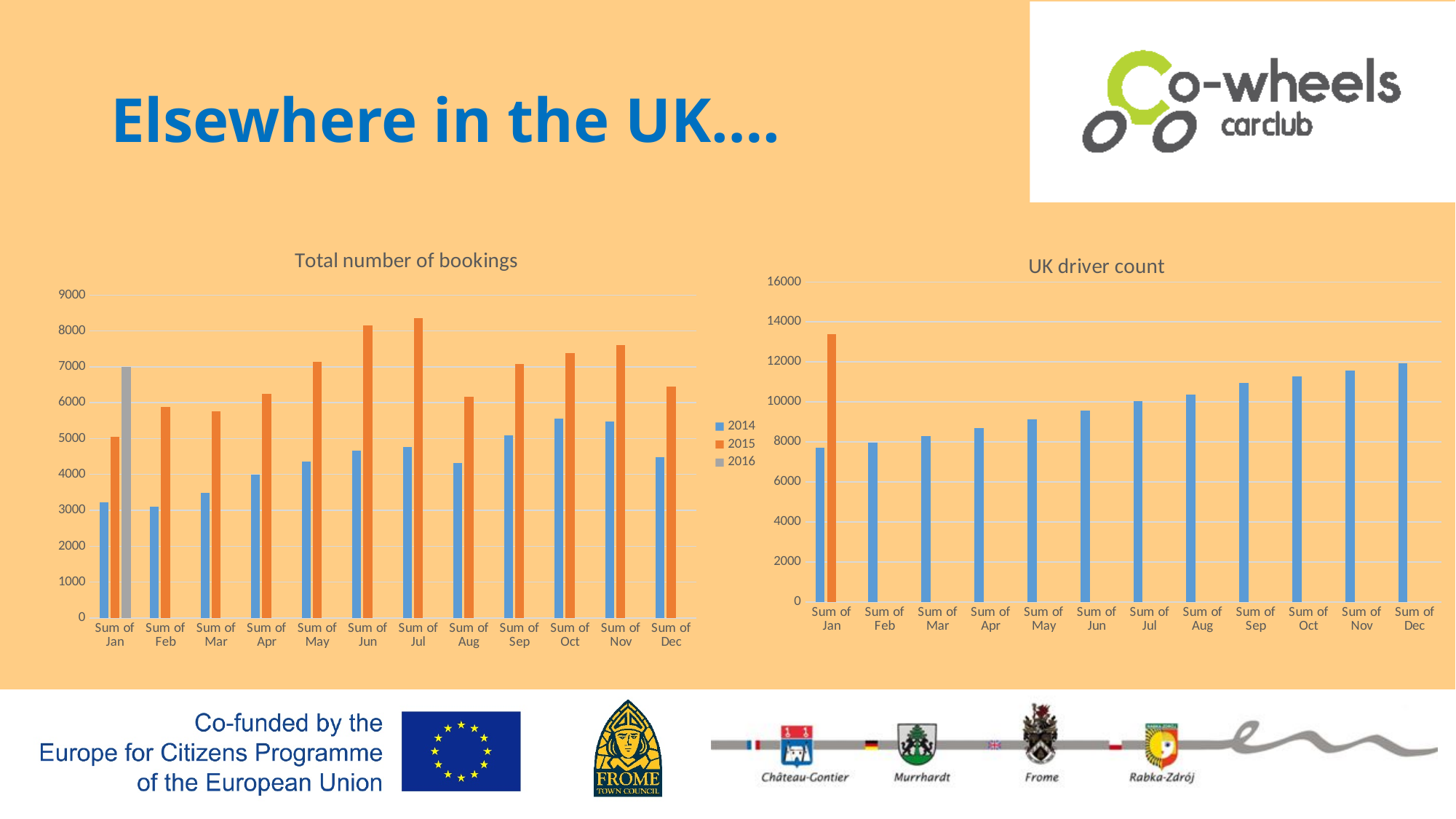
How many series does the legend of the 'Total number of bookings' chart list? 3 In the 'Total number of bookings' chart, is the 2015 value for Sum of Jun greater or less than 8000? greater In the 'Total number of bookings' chart, is the 2014 value for Sum of Aug greater or less than 5000? less In the 'Total number of bookings' chart, which is larger for Sum of Jul: the 2014 value or the 2015 value? 2015 In the 'UK driver count' chart, is the orange bar for Sum of Jan greater or less than 12000? greater In the 'Total number of bookings' chart, which month is the only one with a 2016 bar? Sum of Jan In the 'UK driver count' chart, which is larger: the blue bar for Sum of Jan or the blue bar for Sum of Dec? Sum of Dec How many month categories are shown on the x axis of the 'UK driver count' chart? 12 In the 'Total number of bookings' chart, which month has the lowest 2015 value? Sum of Jan What type of chart is the 'Total number of bookings' chart? bar chart In the 'UK driver count' chart, do the blue bars rise or fall from Sum of Jan to Sum of Dec? rise